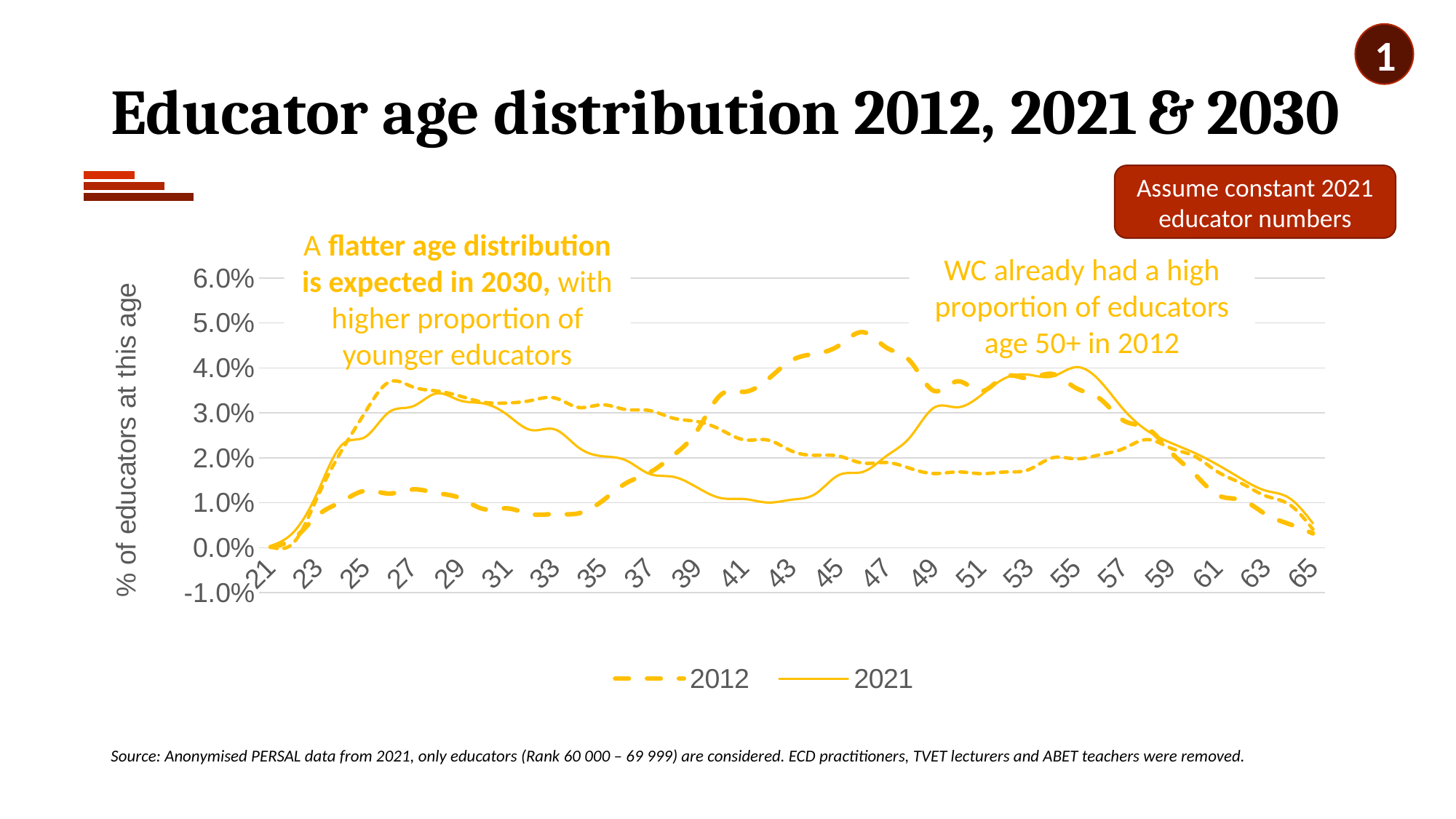
At age 27, which series has the higher value, 2012 or 2021? 2021 Does the 2021 line rise or fall between age 57 and age 65? Fall How many series does the chart legend list? 2 What is the title of the slide containing the chart? Educator age distribution 2012, 2021 & 2030 How many age labels are shown on the x axis? 23 Is the 2012 value at age 33 greater or less than 1.0%? less Is the 2021 value at age 55 greater or less than 3.0%? greater At age 45, which series has the higher value, 2012 or 2021? 2012 What is the label on the vertical axis of the chart? % of educators at this age What kind of chart is shown on the slide? Line chart Is the 2012 value at age 47 greater or less than 4.0%? greater